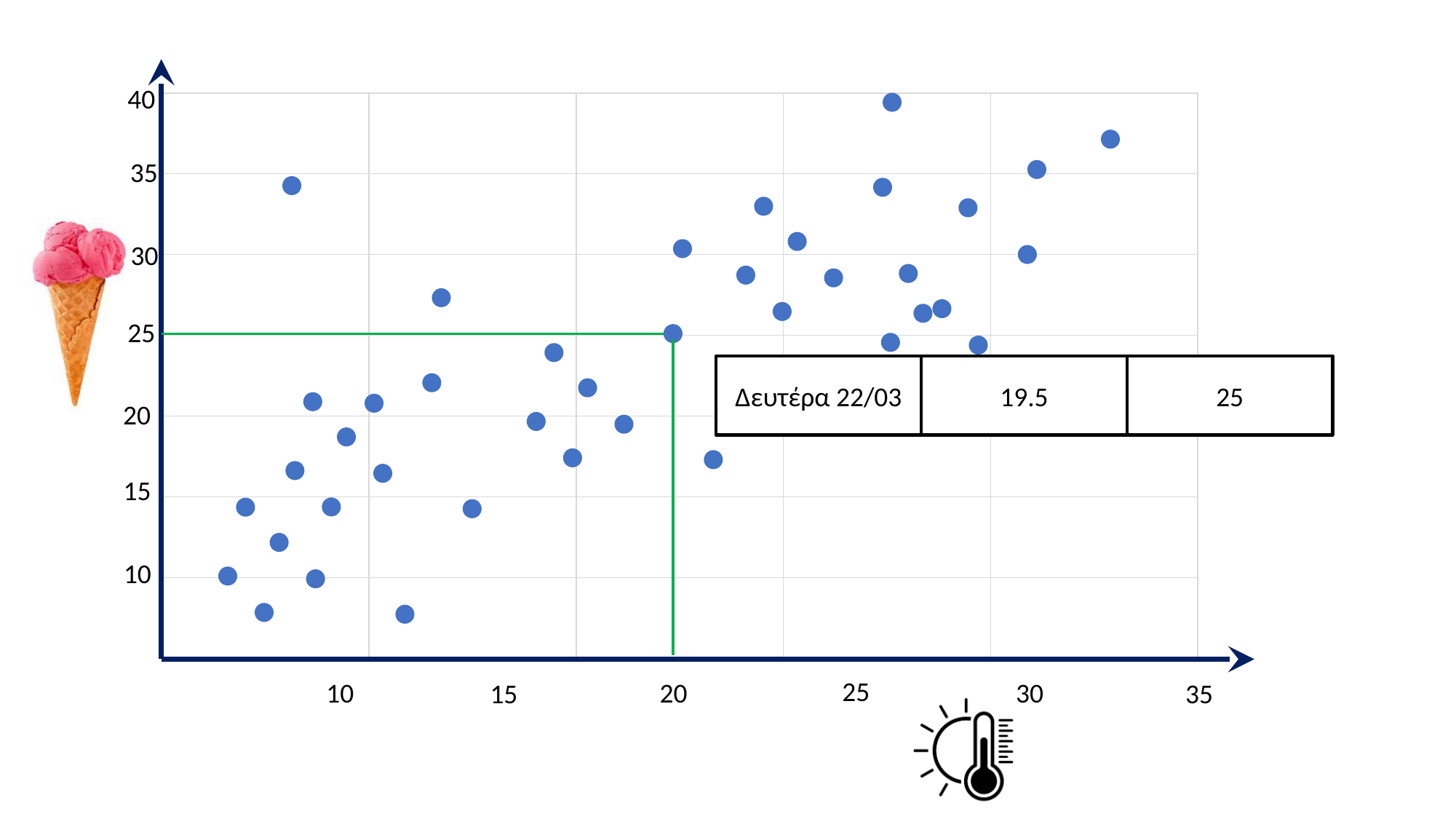
As the x-axis value (temperature) increases, do the plotted y values generally rise or fall? rise What kind of chart is shown on the slide? scatter plot Is the y value of the highest point on the chart greater or less than 35? greater What x value does the green vertical guide line mark on the horizontal axis? 20 Is the x value of the rightmost point on the chart greater or less than 30? greater What y value does the green horizontal guide line mark on the vertical axis? 25 What value is shown in the right-hand cell of the table for Δευτέρα 22/03? 25 What is the largest value labelled on the x-axis? 35 Is the y value of the point plotted near x = 8.5 at the top left of the chart greater or less than 30? greater What date label is shown in the first cell of the table on the chart? Δευτέρα 22/03 What value is shown in the middle cell of the table for Δευτέρα 22/03? 19.5